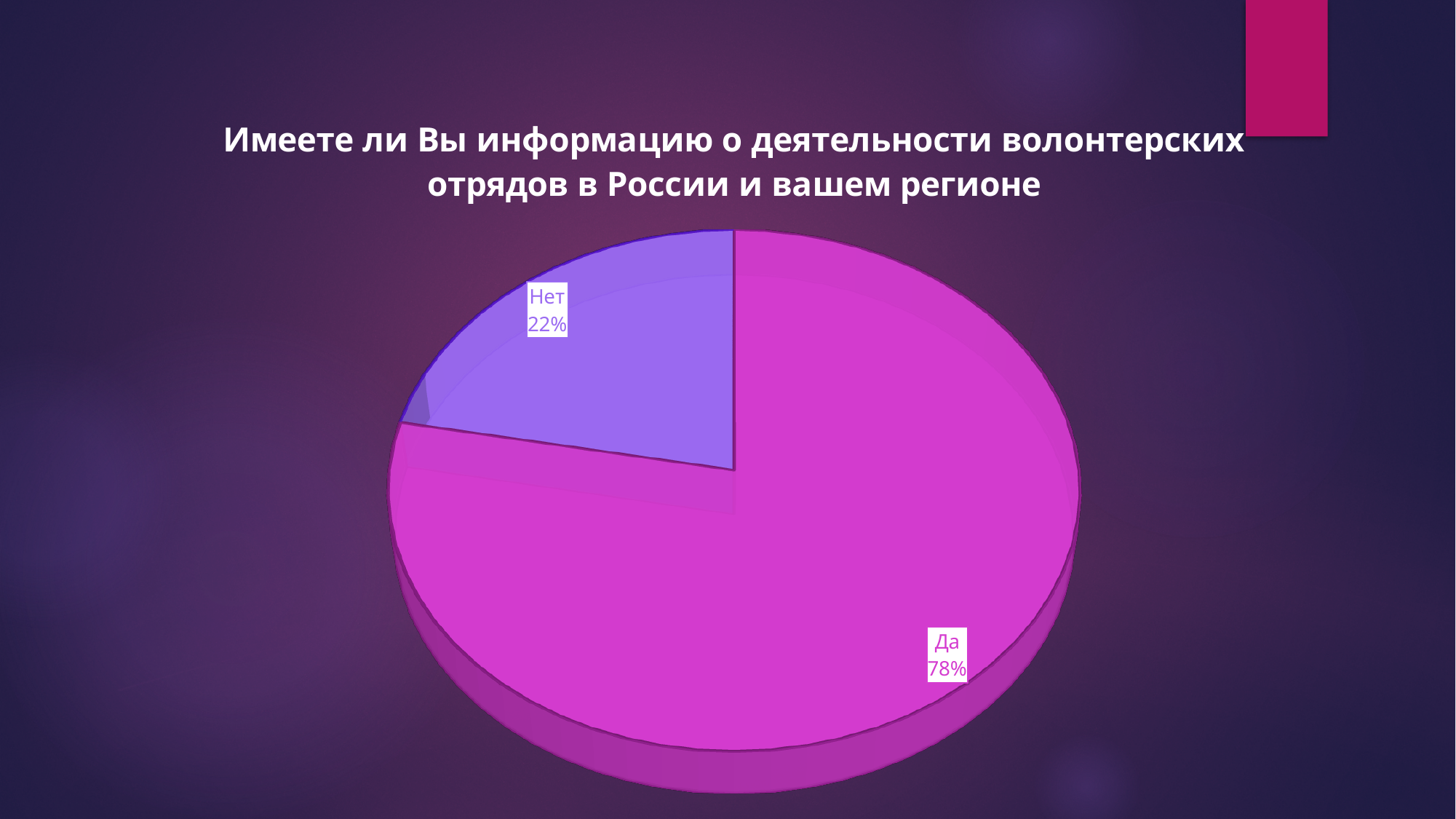
How many slices does the pie chart have? 2 What share of the pie does the "Нет" slice represent? 22% Which slice of the pie is the smallest? Нет What colour is the "Нет" slice? purple What is the difference in percentage points between the "Да" and "Нет" slices? 56 Which is larger, the "Да" slice or the "Нет" slice? Да Which slice of the pie is the largest? Да What percentage of respondents answered "Да"? 78% What is the title of the chart? Имеете ли Вы информацию о деятельности волонтерских отрядов в России и вашем регионе What percentage of respondents answered "Нет"? 22% What kind of chart is shown on the slide? pie chart